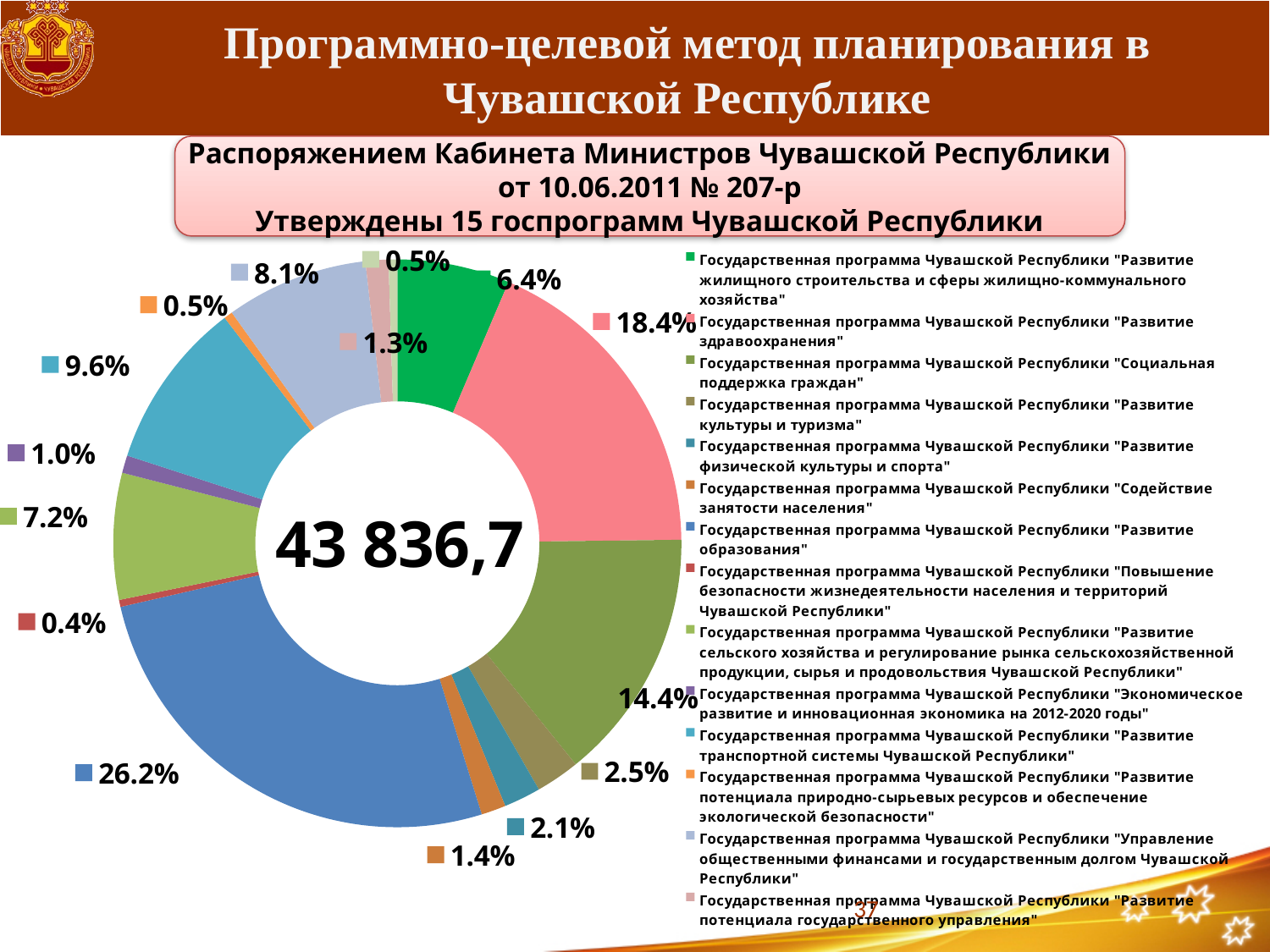
What is the largest share shown in the doughnut chart? 26.2% What value is printed in the centre of the doughnut chart? 43 836,7 What kind of chart is shown on the slide? Doughnut (pie) chart What is the difference between the largest slice (26.2%) and the second largest slice (18.4%)? 7.8% Which is larger, the 2.5% slice or the 2.1% slice? 2.5% What is the difference between the 14.4% slice and the 7.2% slice? 7.2% What share does the programme "Развитие образования" (blue slice) have in the chart? 26.2% How many slices in the chart are labelled 0.5%? 2 What share does the programme "Развитие здравоохранения" (pink slice) have in the chart? 18.4% Which is larger, the 9.6% slice or the 8.1% slice? 9.6% What is the smallest share shown in the doughnut chart? 0.4% How many slices does the doughnut chart have? 15